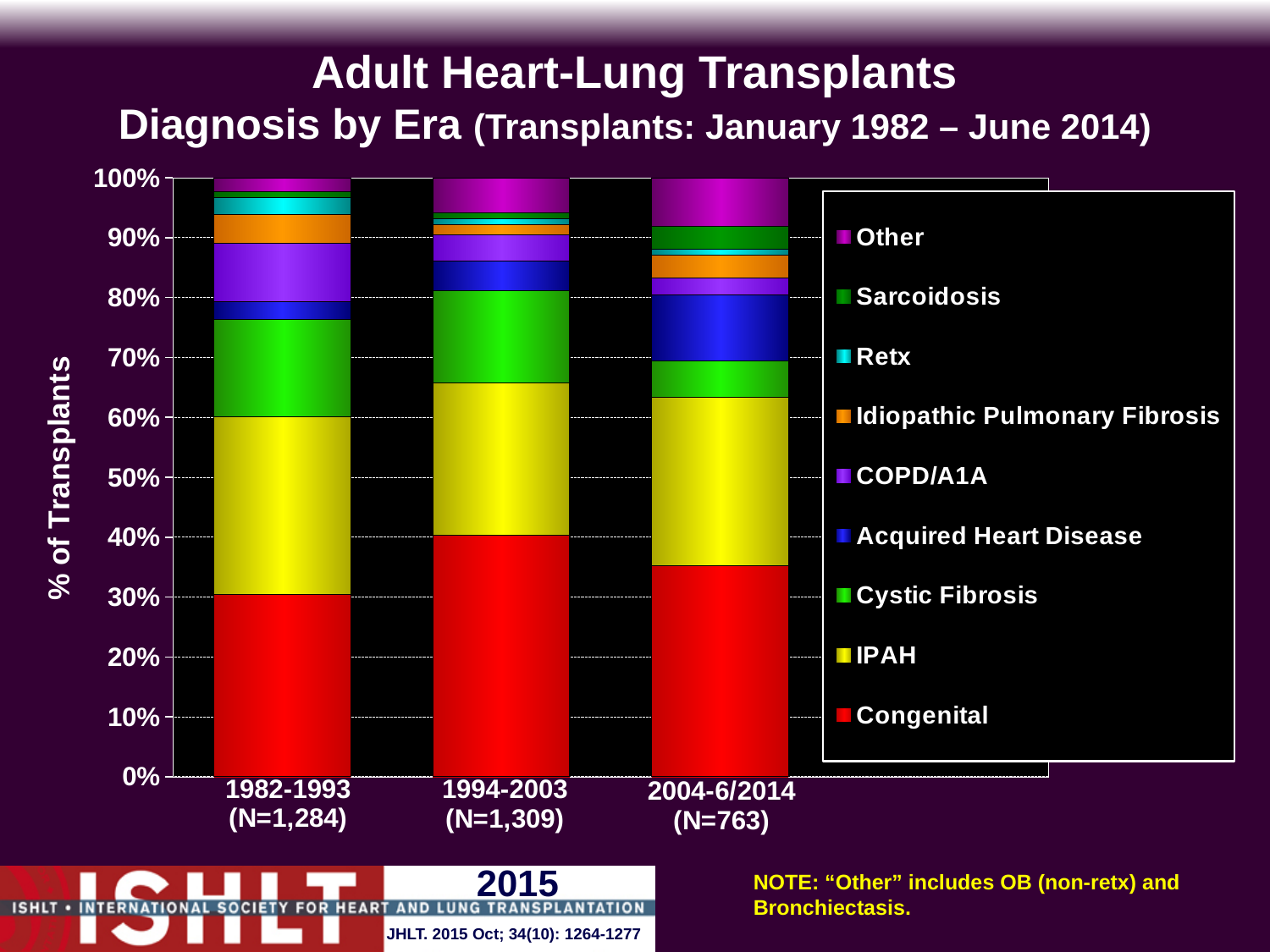
What is the label on the y axis? % of Transplants What kind of chart is shown on the slide? stacked bar chart How many diagnosis series does the legend list? 9 How many era categories (bars) are plotted on the x axis? 3 Is the top of the Congenital segment for 2004-6/2014 greater or less than 40%? less Which era has the larger Congenital share: 1982-1993 or 1994-2003? 1994-2003 What does each stacked bar total, as shown by the y axis? 100% What is the N shown for the 1982-1993 era? N=1,284 Which era has the larger Acquired Heart Disease share: 1982-1993 or 2004-6/2014? 2004-6/2014 Is the top of the IPAH segment for 1994-2003 greater or less than 60%? greater Is the top of the Cystic Fibrosis segment for 1982-1993 greater or less than 70%? greater